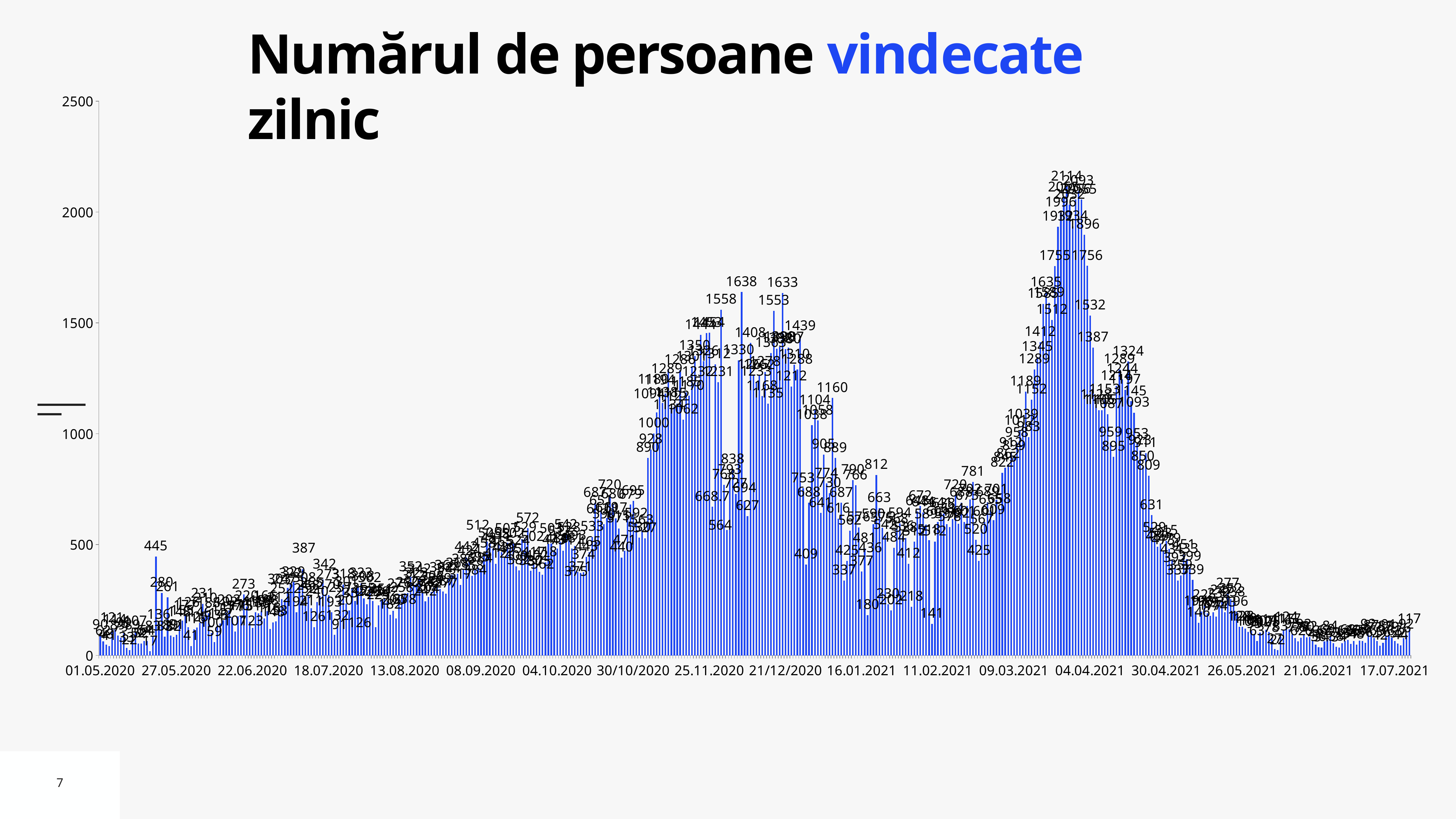
Which is larger: the peak around 04.04.2021 or the peak around 25.11.2020? the peak around 04.04.2021 What is the highest value labelled on the chart? 2114 What is the highest value labelled in the peak between 25.11.2020 and 21/12/2020? 1638 Is the value for the last bar at 17.07.2021 greater or less than 500? less What kind of chart is shown on the slide? bar chart What is the maximum value shown on the y axis? 2500 How many date labels are shown on the x axis? 18 What is the value labelled on the last bar, at 17.07.2021? 117 Is the tallest bar near 04.04.2021 greater or less than 2000? greater Do the values rise or fall between 04.04.2021 and 17.07.2021? fall What is the difference between the overall peak value of 2114 and the late-2020 peak value of 1638? 476 What is the title of the chart? Numărul de persoane vindecate zilnic